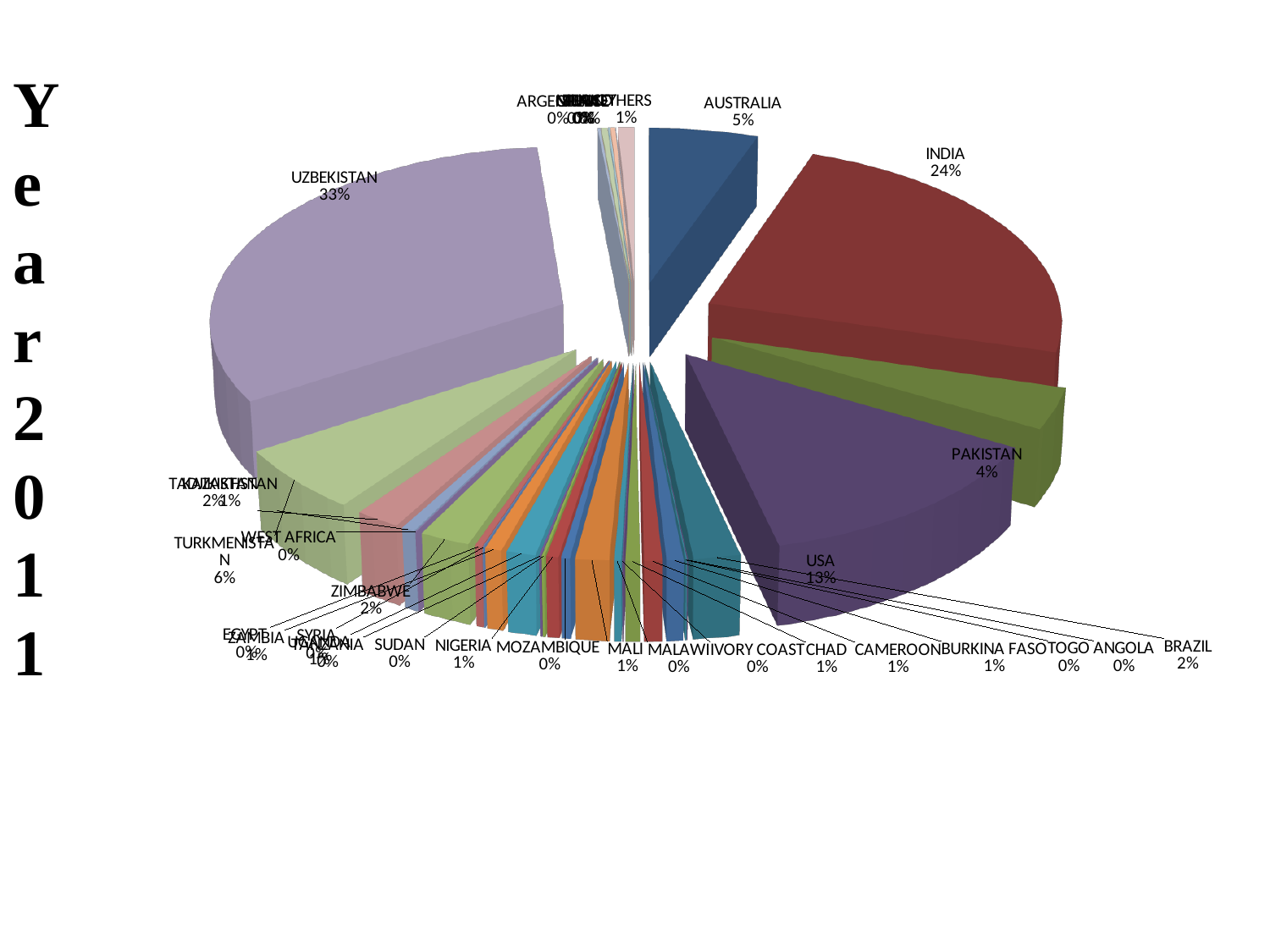
What is the value shown for BRAZIL? 2% What is the value shown for USA? 13% What kind of chart is shown on the slide? pie chart Which country has the largest slice of the pie? UZBEKISTAN What is the value shown for PAKISTAN? 4% What share of the pie does UZBEKISTAN hold? 33% What year does the text on the left of the slide indicate the chart is for? 2011 What is the value shown for INDIA? 24% What is the value shown for AUSTRALIA? 5% What is the difference in percentage points between UZBEKISTAN and INDIA? 9 What is the value shown for TURKMENISTAN? 6% Which is larger, the share for INDIA or the share for USA? INDIA